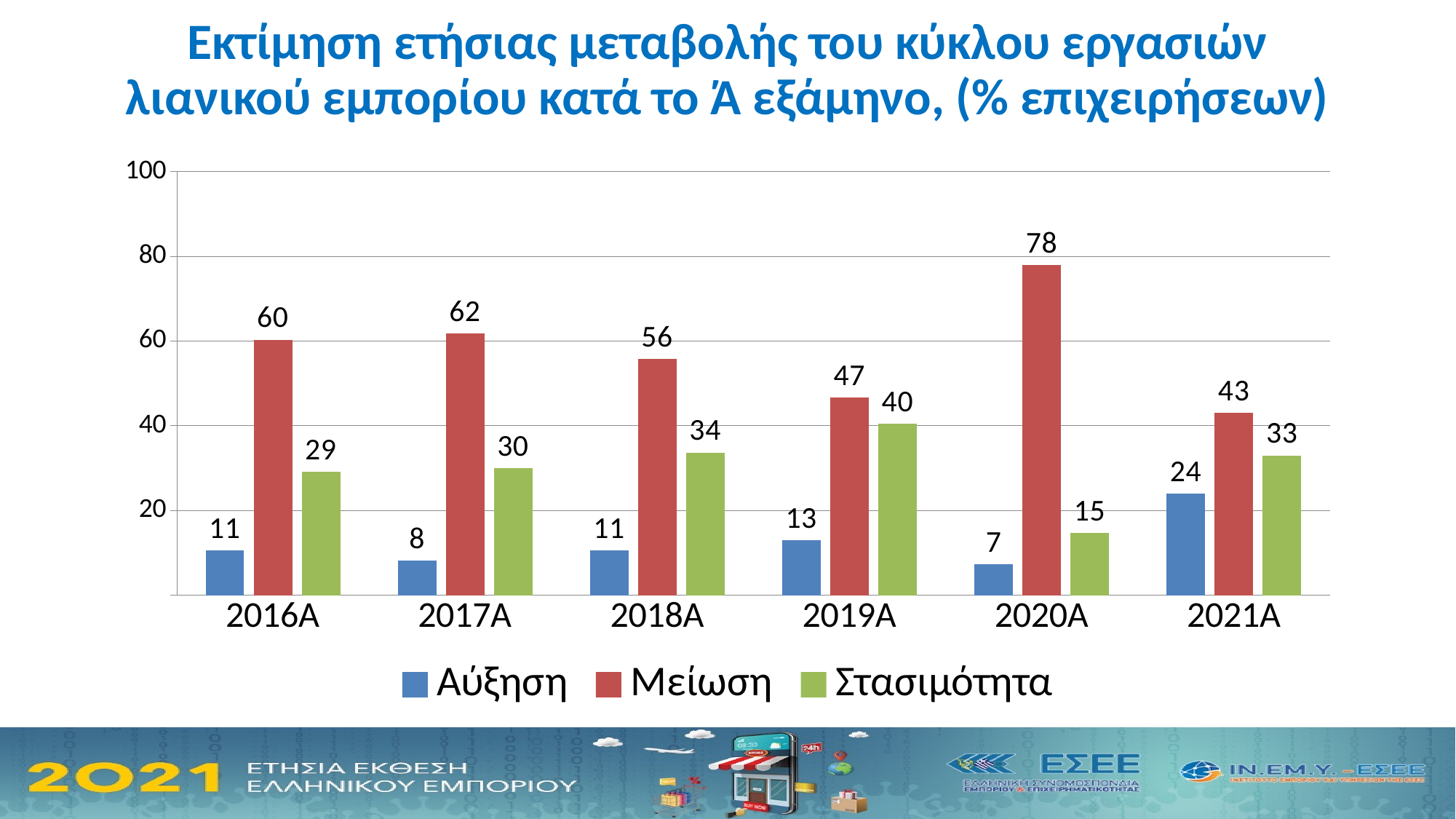
How many years are shown on the x axis? 6 What is the value for Αύξηση in 2021A? 24 In which year is the Μείωση value highest? 2020A In which year is the Αύξηση value lowest? 2020A How many series does the legend list? 3 What is the value for Στασιμότητα in 2019A? 40 What is the value for Μείωση in 2020A? 78 Which is larger, Στασιμότητα in 2018A or Στασιμότητα in 2019A? Στασιμότητα in 2019A What kind of chart is shown on the slide? bar chart Which colour represents Στασιμότητα in the legend? green What is the difference between the Μείωση values for 2020A and 2021A? 35 Does the Μείωση value rise or fall from 2016A to 2017A? rise